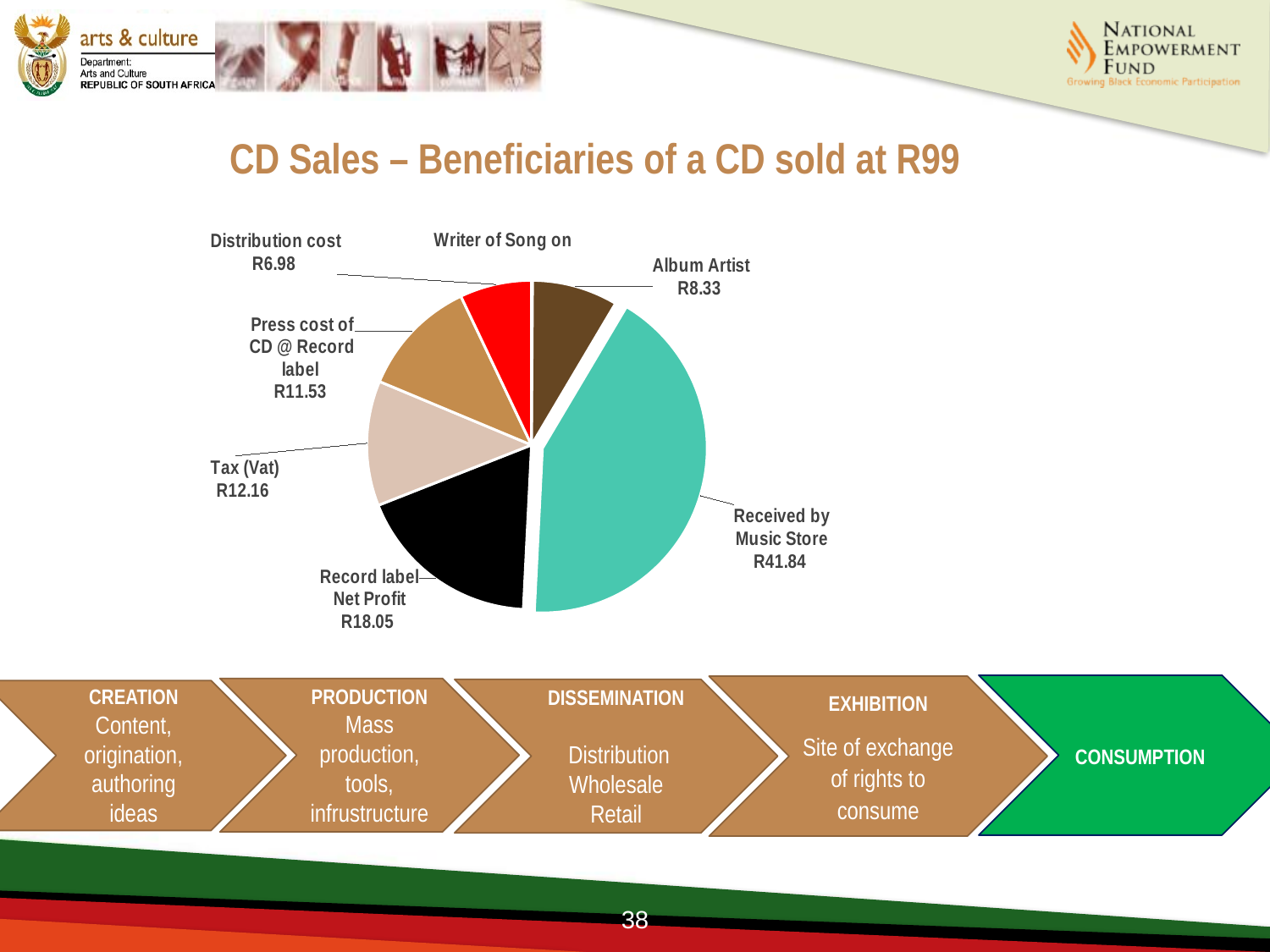
What is the Distribution cost shown in the pie chart? R6.98 What is the difference between the amount received by the Music Store and the Record label Net Profit? R23.79 Which is larger: Tax (Vat) or the amount received by the Album Artist? Tax (Vat) How many slices does the pie chart have? 7 What amount is received by the Music Store from a CD sold at R99? R41.84 What is the Record label Net Profit shown in the pie chart? R18.05 What is the title of the slide containing the pie chart? CD Sales – Beneficiaries of a CD sold at R99 Which beneficiary receives the largest share of the CD sale? Received by Music Store What kind of chart is shown on the slide? pie chart How much does the Album Artist receive according to the pie chart? R8.33 What is the value for Tax (Vat) in the pie chart? R12.16 What is the Press cost of CD @ Record label? R11.53